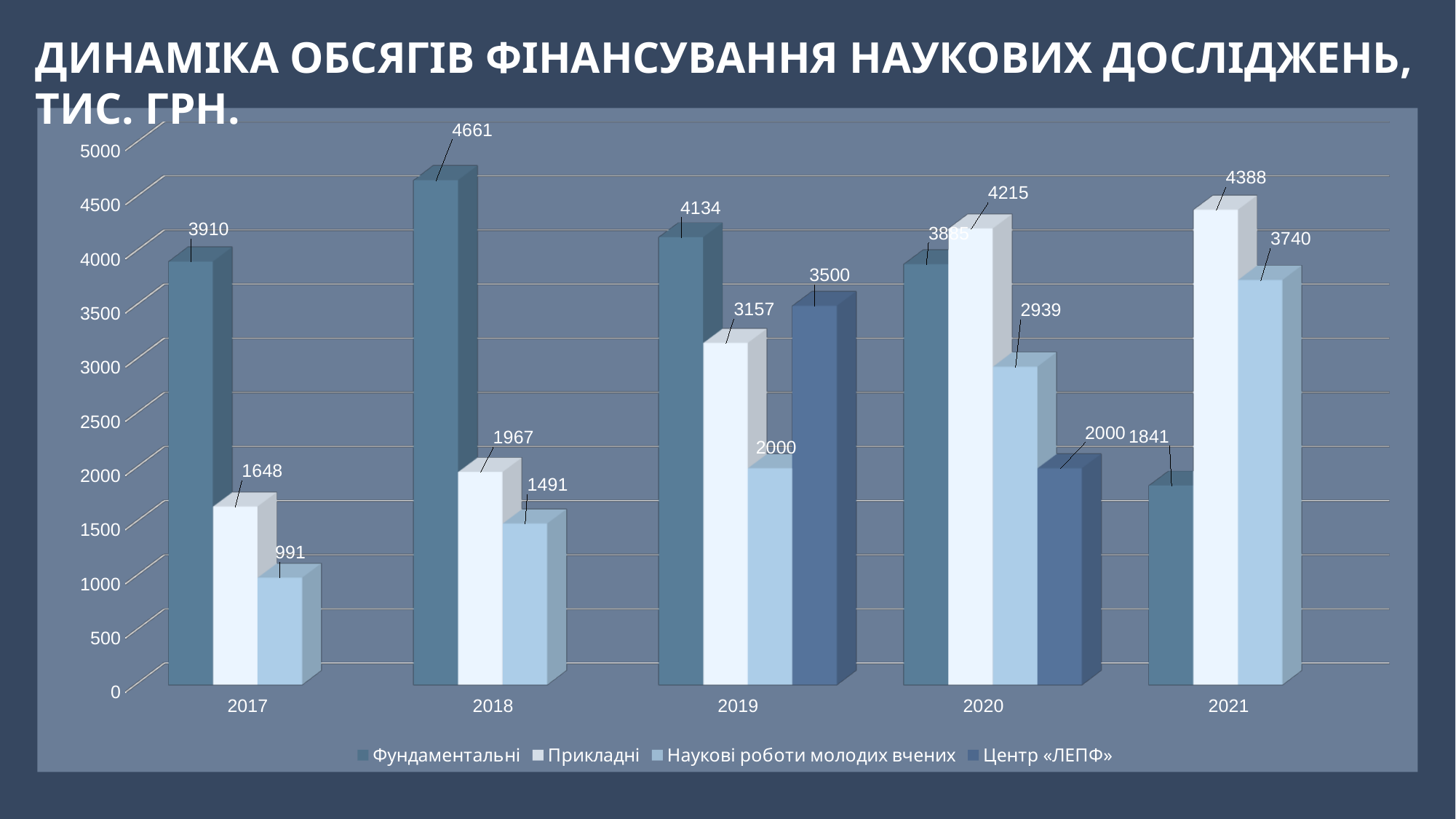
In which year is the value for Фундаментальні the highest? 2018 By how much did the value for Прикладні increase from 2017 to 2018? 319 Does the value for Прикладні rise or fall from 2017 to 2021? rises Is the value for Фундаментальні in 2021 greater or less than 2000? less How many years are shown on the x axis? 5 What is the value for Фундаментальні in 2018? 4661 In which year is the value for Наукові роботи молодих вчених the lowest? 2017 What is the value for Прикладні in 2021? 4388 What is the value for Центр «ЛЕПФ» in 2019? 3500 How many series does the legend list? 4 What kind of chart is shown on the slide? bar chart In 2021, which is larger: Прикладні or Наукові роботи молодих вчених? Прикладні